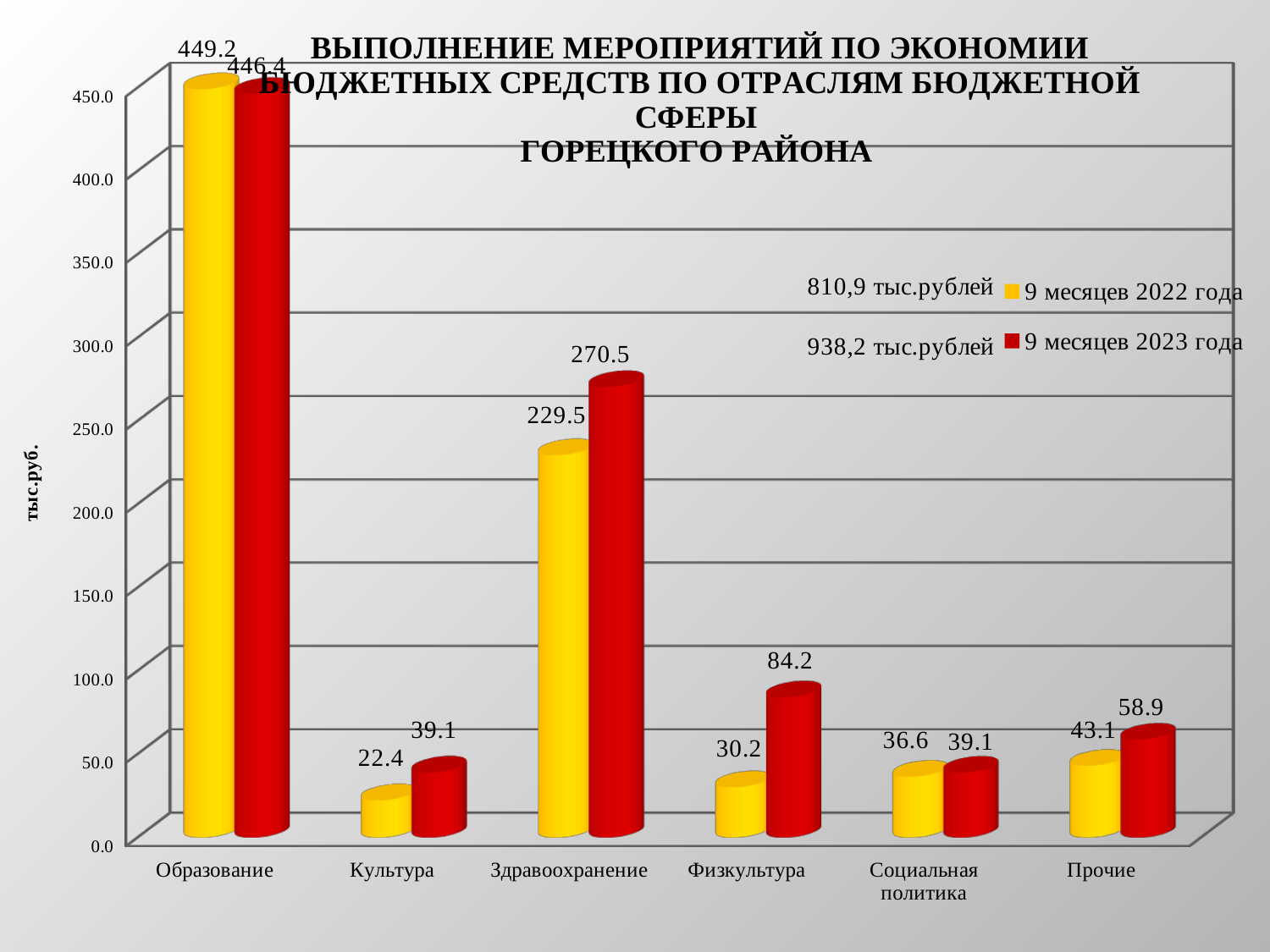
How many categories are shown on the x axis? 6 Which category has the highest value in the series 9 месяцев 2022 года? Образование Is the value for Прочие in the series 9 месяцев 2023 года greater or less than 50.0? greater What is the value for Здравоохранение in the series 9 месяцев 2023 года? 270.5 What is the difference between the 9 месяцев 2023 года and 9 месяцев 2022 года values for Физкультура? 54.0 What is the value for Физкультура in the series 9 месяцев 2023 года? 84.2 Which category has the lowest value in the series 9 месяцев 2022 года? Культура What kind of chart is shown on the slide? Bar chart What is the value for Культура in the series 9 месяцев 2022 года? 22.4 What is the label of the vertical axis? тыс.руб. Which is larger for Образование: the value for 9 месяцев 2022 года or for 9 месяцев 2023 года? 9 месяцев 2022 года How many series does the legend list? 2